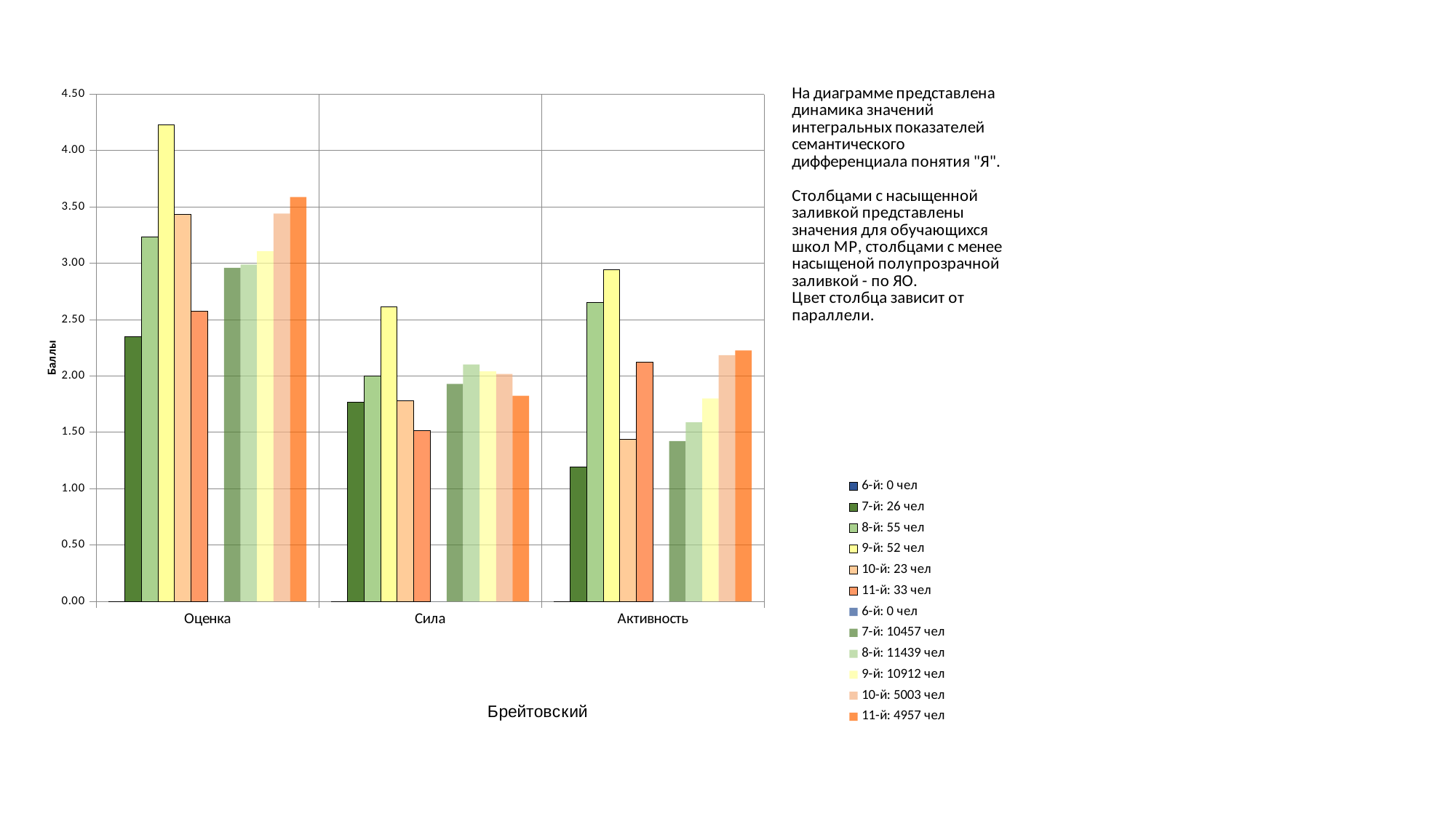
Do the values for 7-й: 26 чел rise or fall from Оценка to Сила to Активность? fall How many categories are shown on the x axis of the chart? 3 Is the value for 11-й: 4957 чел in the Оценка category greater or less than 3.50? greater How many series does the legend list? 12 Is the value for 7-й: 26 чел in the Активность category greater or less than 1.50? less Is the value for 9-й: 52 чел in the Оценка category greater or less than 4.00? greater Which series has the lowest bar in the Активность category? 7-й: 26 чел In the Оценка category, which is larger: the value for 9-й: 52 чел or the value for 11-й: 33 чел? 9-й: 52 чел What is the label of the vertical axis? Баллы Which series has the highest bar in the Оценка category? 9-й: 52 чел What kind of chart is shown on the slide? Bar chart What is the title shown below the chart? Брейтовский